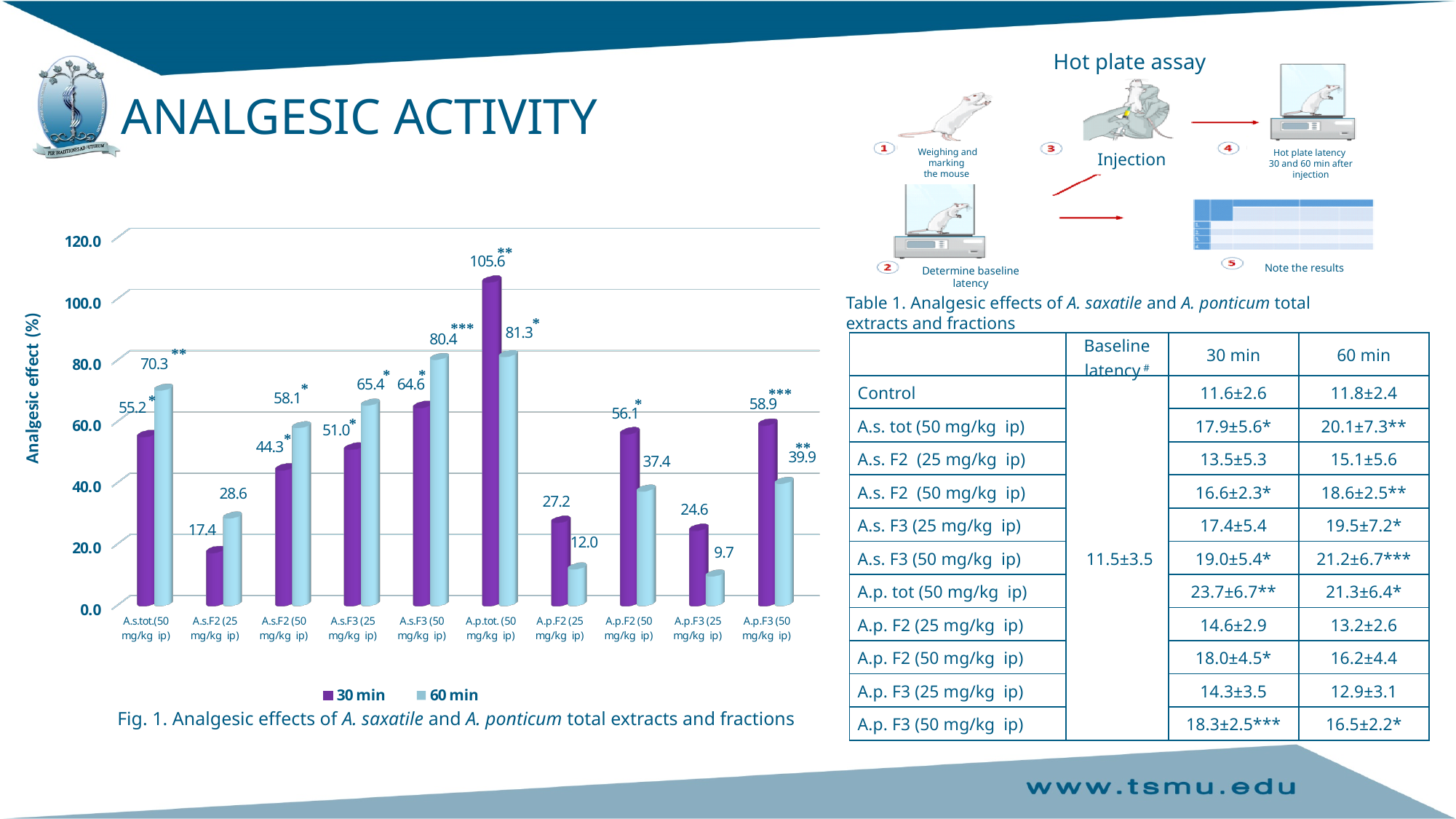
Which category has the lowest 60 min value? A.p.F3 (25 mg/kg ip) How many categories are shown on the x axis of the chart? 10 For A.s.tot. (50 mg/kg ip), which is larger, the 30 min value or the 60 min value? 60 min What is the difference between the 30 min and 60 min values for A.p.tot. (50 mg/kg ip)? 24.3 Which category has the highest 30 min value? A.p.tot. (50 mg/kg ip) What is the label of the y axis of the chart? Analgesic effect (%) What is the 30 min value for A.p.tot. (50 mg/kg ip)? 105.6 What type of chart is shown in Fig. 1? bar chart What is the 60 min value for A.p.F3 (25 mg/kg ip)? 9.7 Is the 30 min value for A.s.F2 (25 mg/kg ip) greater or less than 20.0? less What is the 60 min value for A.s.F3 (50 mg/kg ip)? 80.4 How many series does the legend of the chart list? 2